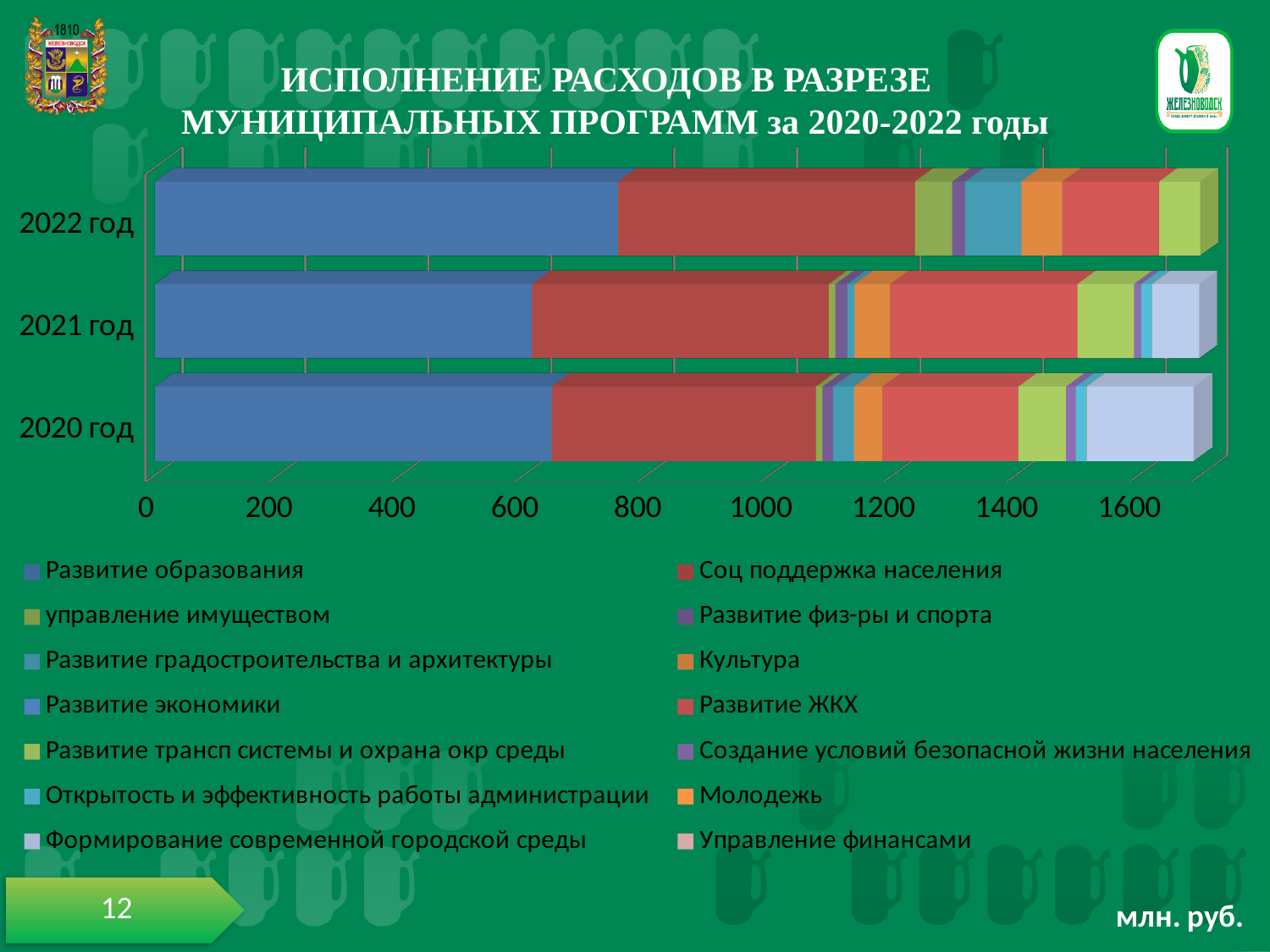
Is the value for Развитие образования in 2022 год greater or less than 600? greater Is the value for Развитие образования in 2021 год greater or less than 800? less Is the value for Развитие образования in 2022 год greater or less than 800? less What kind of chart is shown on the slide? bar chart In what units are the values on the chart expressed, according to the slide? млн. руб. Which is larger, the Развитие образования value for 2022 год or for 2021 год? 2022 год How many series does the legend list? 14 Which is larger, the Формирование современной городской среды value for 2020 год or for 2021 год? 2020 год Which year has the largest Развитие образования segment? 2022 год How many years (categories) are plotted on the chart? 3 Which is larger, the Развитие ЖКХ value for 2021 год or for 2022 год? 2021 год